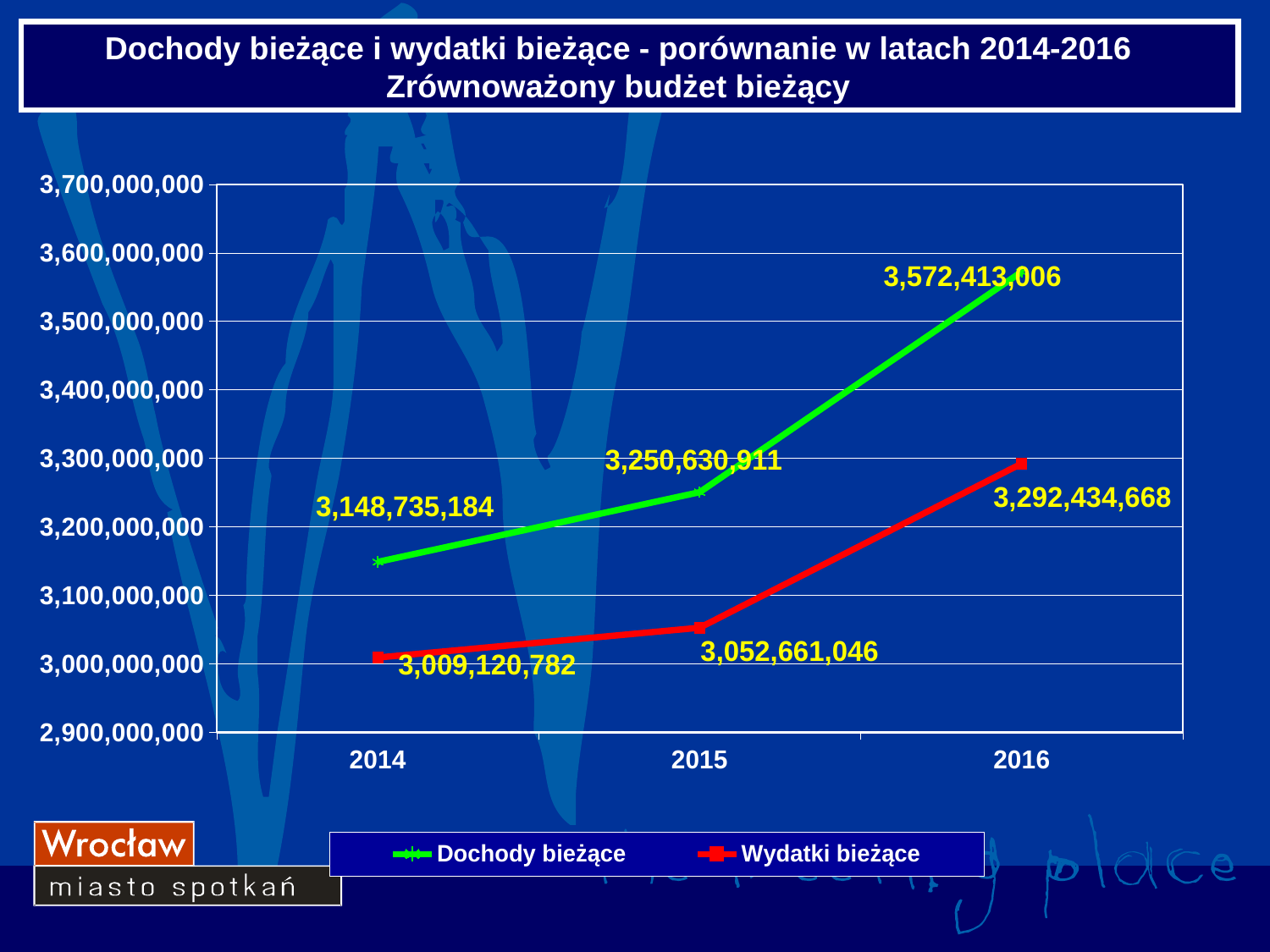
Which is larger in 2015, Dochody bieżące or Wydatki bieżące? Dochody bieżące How many series does the legend list? 2 What is the value of Wydatki bieżące in 2016? 3,292,434,668 What kind of chart is shown on the slide? Line chart What is the value of Wydatki bieżące in 2014? 3,009,120,782 What is the difference between Dochody bieżące and Wydatki bieżące in 2016? 279,978,338 In which year is Wydatki bieżące highest? 2016 By how much did Dochody bieżące increase from 2014 to 2016? 423,677,822 In which year is Dochody bieżące lowest? 2014 What is the value of Dochody bieżące in 2015? 3,250,630,911 What is the value of Dochody bieżące in 2016? 3,572,413,006 Do the values of Wydatki bieżące rise or fall from 2014 to 2016? Rise